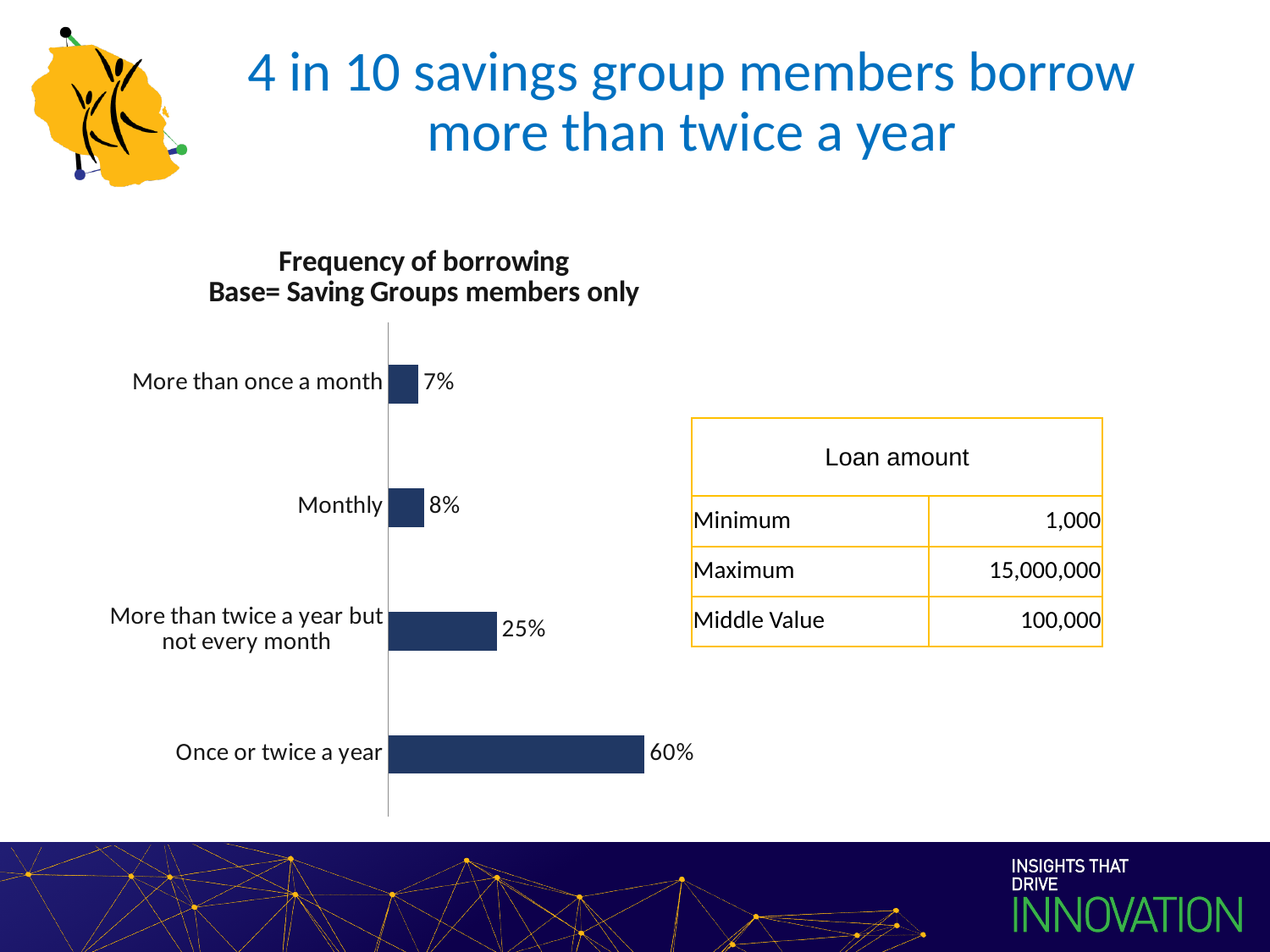
What type of chart is used to show the frequency of borrowing? Bar chart What is the combined percentage of members who borrow monthly or more than once a month? 15% What is the difference in percentage points between 'Once or twice a year' and 'More than twice a year but not every month'? 35 How many borrowing frequency categories are shown in the chart? 4 Which borrowing frequency category has the highest percentage? Once or twice a year What percentage of savings group members borrow more than twice a year but not every month? 25% Which is larger: the percentage for 'Monthly' or for 'More than once a month'? Monthly What is the title of the chart? Frequency of borrowing Base= Saving Groups members only What percentage of savings group members borrow once or twice a year? 60% What percentage of savings group members borrow more than once a month? 7% Which borrowing frequency category has the lowest percentage? More than once a month What percentage of savings group members borrow monthly? 8%